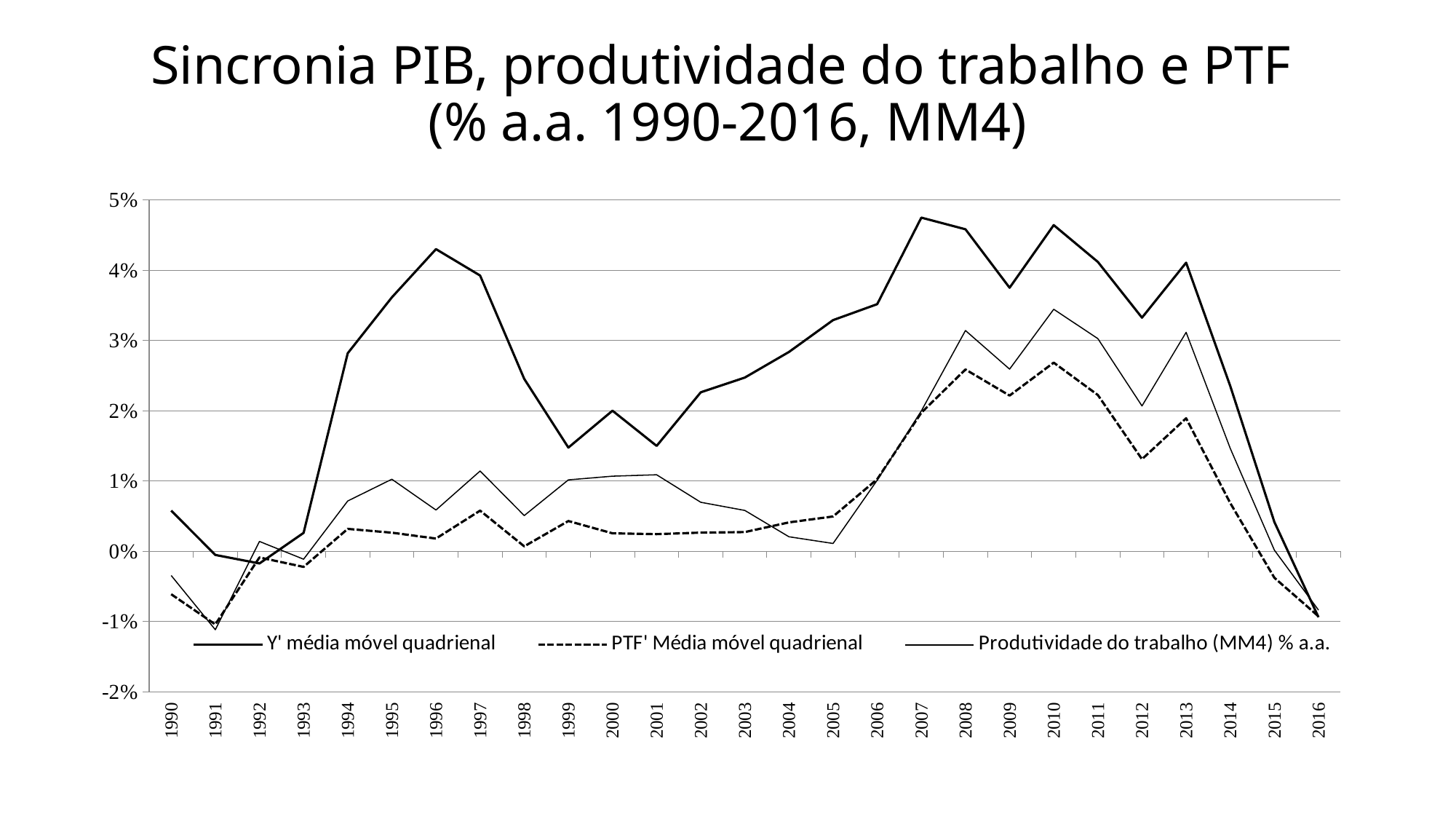
Is the value of Y' média móvel quadrienal in 1996 greater or less than 4%? greater Is the value of Produtividade do trabalho (MM4) % a.a. in 2010 greater or less than 3%? greater In which year does Produtividade do trabalho (MM4) % a.a. reach its highest value? 2010 Is the value of Y' média móvel quadrienal in 1999 greater or less than 2%? less Does Y' média móvel quadrienal rise or fall from 2013 to 2016? fall In 2007, which series has the higher value: Y' média móvel quadrienal or PTF' Média móvel quadrienal? Y' média móvel quadrienal How many series does the legend list? 3 What kind of chart is shown on the slide? line chart How many years are plotted along the x axis? 27 What is the title of the chart? Sincronia PIB, produtividade do trabalho e PTF (% a.a. 1990-2016, MM4) In which year does Y' média móvel quadrienal reach its lowest value? 2016